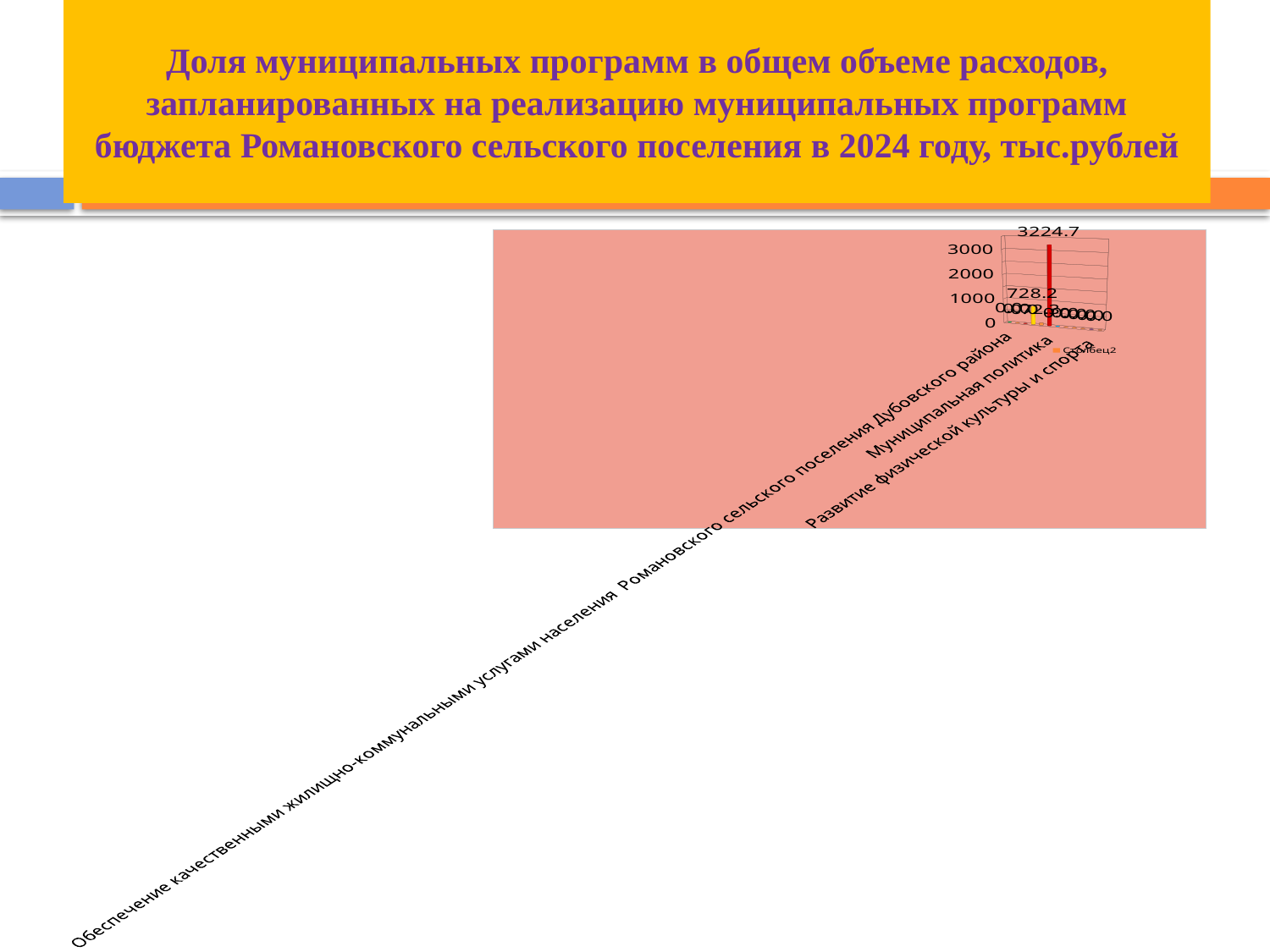
How many series does the legend list? 1 What entry does the chart legend list? Столбец2 What is the highest tick value shown on the vertical axis? 3000 Is the value 728.2 greater or less than 1000? less What is the largest value labelled on the chart? 3224.7 What is the difference between the two labelled values 3224.7 and 728.2? 2496.5 Which bar is taller, the red bar or the yellow bar? the red bar What is the value shown on the data label of the shorter yellow bar? 728.2 What kind of chart is shown on the slide? bar chart Is the value of the tallest bar (3224.7) greater or less than 3000? greater